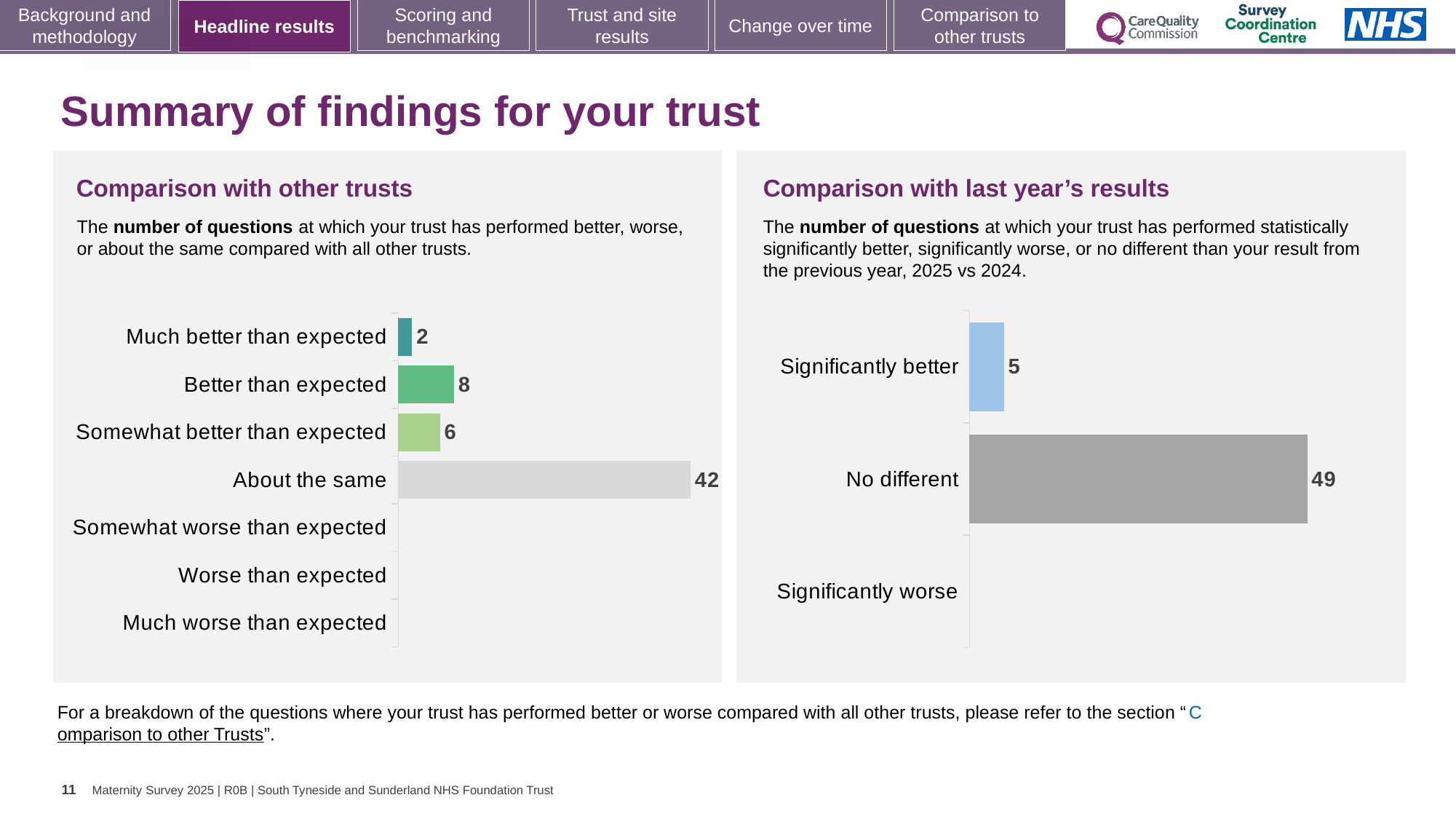
In the 'Comparison with other trusts' chart, what is the value for 'Better than expected'? 8 In the 'Comparison with other trusts' chart, what is the difference between 'Better than expected' and 'Somewhat better than expected'? 2 In the 'Comparison with other trusts' chart, which category has the highest value? About the same What type of chart is used in the 'Comparison with other trusts' panel? Bar chart In the 'Comparison with last year's results' chart, what is the value for 'Significantly better'? 5 In the 'Comparison with other trusts' chart, what is the value for 'Much better than expected'? 2 In the 'Comparison with other trusts' chart, how many categories are listed on the axis? 7 In the 'Comparison with other trusts' chart, how many questions are 'About the same'? 42 In the 'Comparison with last year's results' chart, which category has the highest value? No different In the 'Comparison with last year's results' chart, what is the value for 'No different'? 49 Which is larger: 'About the same' in the 'Comparison with other trusts' chart or 'No different' in the 'Comparison with last year's results' chart? No different In the 'Comparison with last year's results' chart, what is the difference between 'No different' and 'Significantly better'? 44